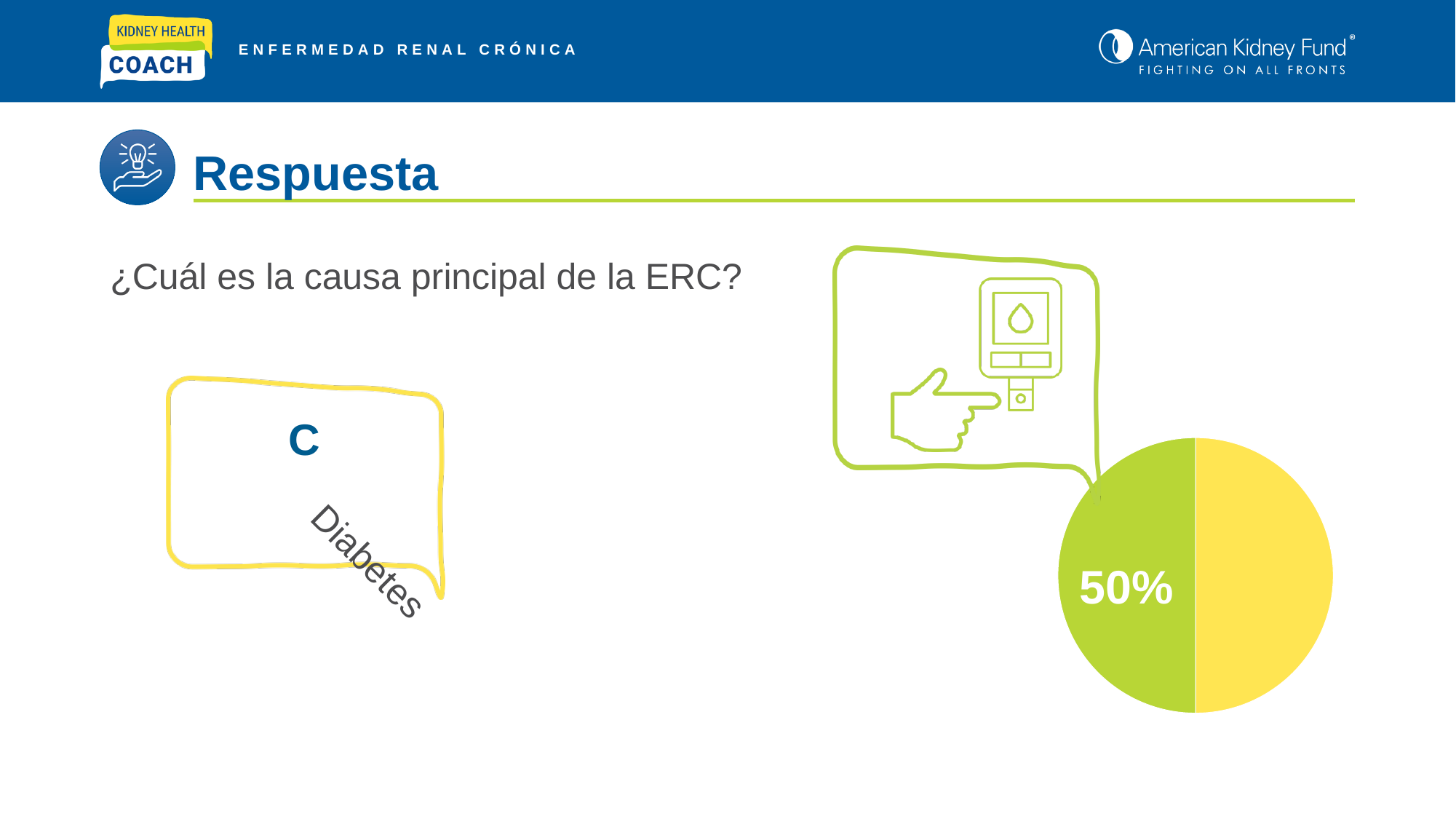
What colour is the slice of the pie chart labelled 50%? green What share of the pie does the green slice represent? 50% What kind of chart is shown on the slide? pie chart What two colours are used for the slices of the pie chart? green and yellow How many slices does the pie chart have? 2 Is the share of the green slice greater or less than 25%? greater What value is printed on the green slice of the pie chart? 50%